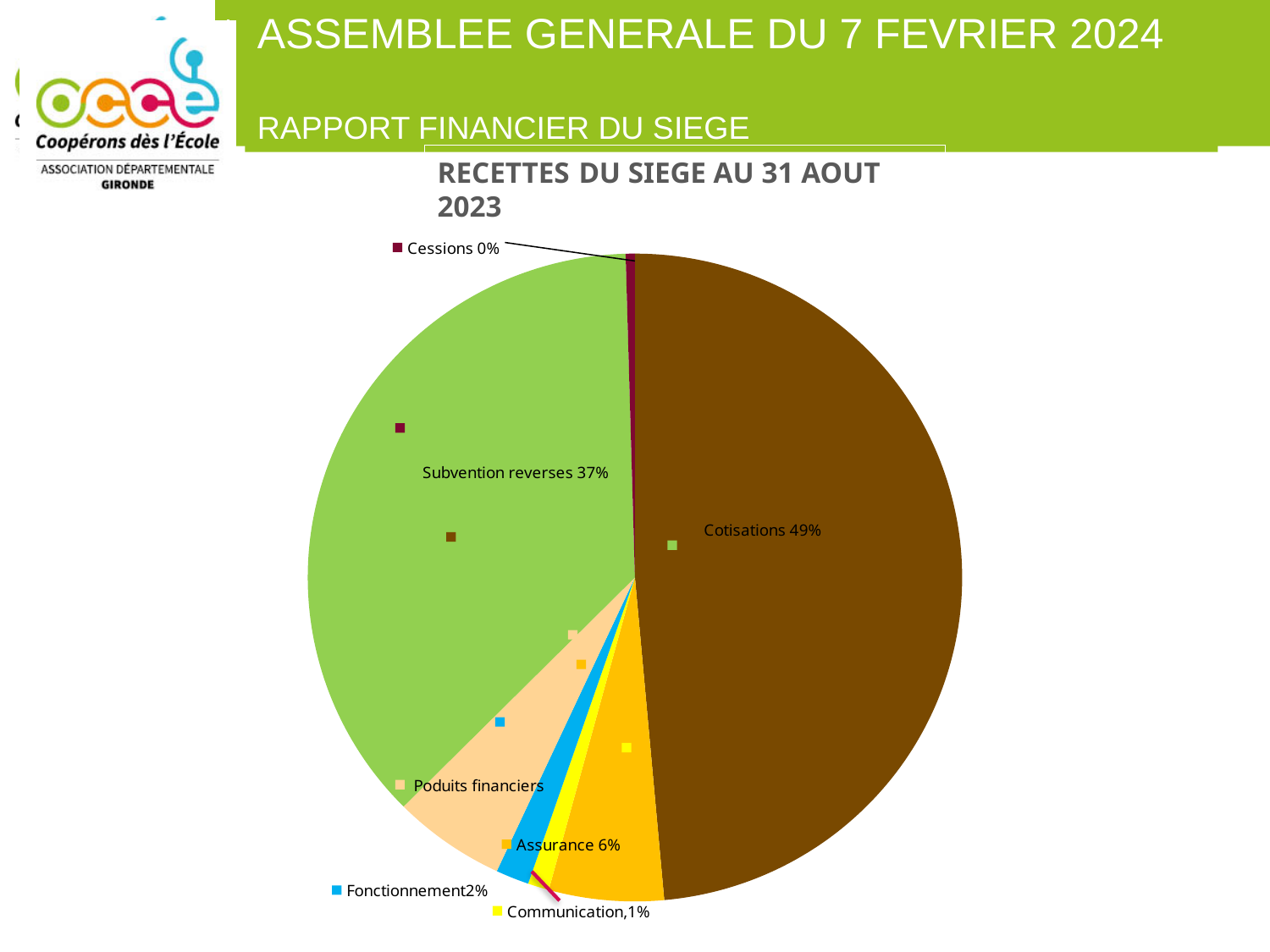
What share of the pie does Cotisations represent? 49% What percentage is shown for Subvention reverses? 37% What is the difference in percentage points between Cotisations and Subvention reverses? 12 What percentage is shown for Fonctionnement? 2% Which category has the largest slice of the pie? Cotisations Which is larger, Subvention reverses or Assurance? Subvention reverses What percentage is shown for Communication? 1% What percentage is shown for Assurance? 6% What is the title of the chart? RECETTES DU SIEGE AU 31 AOUT 2023 What kind of chart is shown on the slide? pie chart Which category has the smallest share, shown as 0%? Cessions How many categories are shown in the pie chart? 7